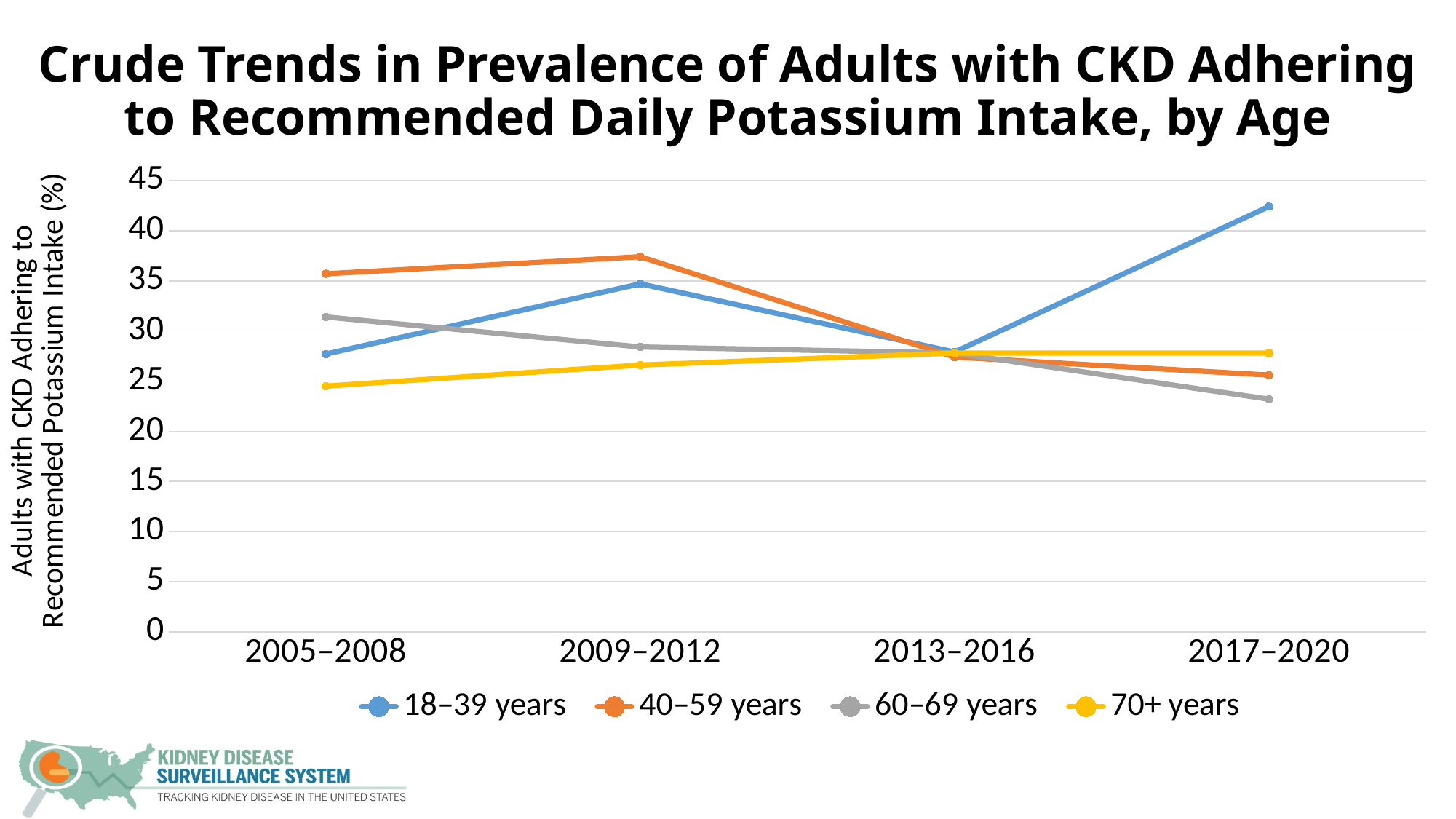
What is the label on the y axis? Adults with CKD Adhering to Recommended Potassium Intake (%) What kind of chart is shown on the slide? Line chart How many age groups does the legend list? 4 Which age group has the lowest value in 2017–2020? 60–69 years Is the value for 60–69 years in 2017–2020 greater or less than 25? less Is the value for 18–39 years in 2017–2020 greater or less than 40? greater In 2005–2008, which is larger: the value for 40–59 years or the value for 18–39 years? 40–59 years Does the value for 60–69 years rise or fall from 2005–2008 to 2017–2020? Falls How many time periods are shown on the x axis? 4 Which age group has the highest value in 2017–2020? 18–39 years Which age group has the lowest value in 2005–2008? 70+ years Which age group has the highest value in 2005–2008? 40–59 years